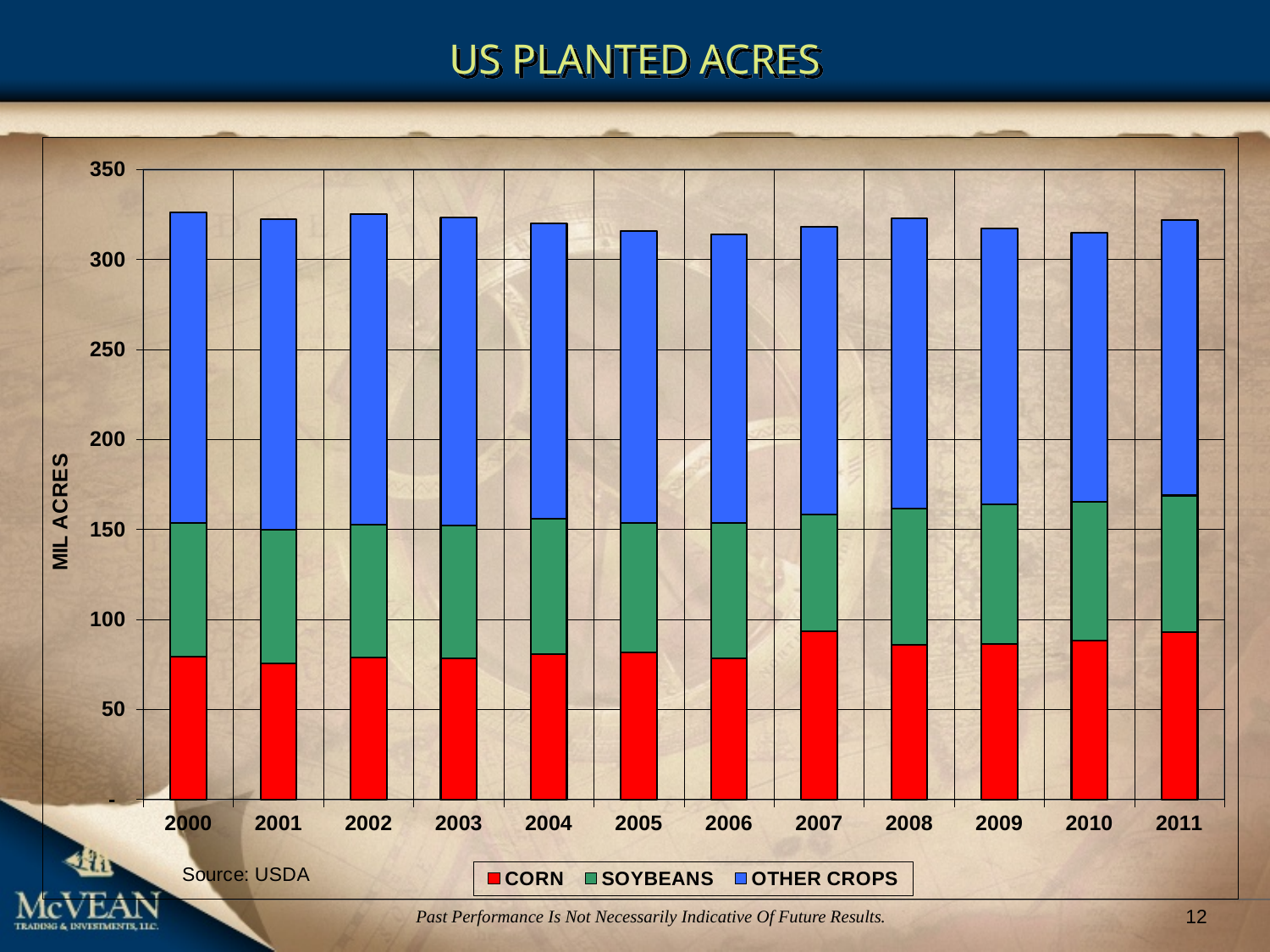
Is the total height of the stacked bar for 2000 greater or less than 300? greater Which is larger, the total stacked bar for 2000 or the total stacked bar for 2006? 2000 Is the total height of the stacked bar for 2006 greater or less than 350? less How many years are shown on the x axis? 12 Is the CORN value for 2000 greater or less than 100? less What is the label on the vertical axis? MIL ACRES What kind of chart is shown on the slide? Stacked bar chart Which series are listed in the legend? CORN, SOYBEANS, OTHER CROPS Which is larger, the CORN value for 2007 or the CORN value for 2001? 2007 What is the title of the chart? US PLANTED ACRES How many series does the legend list? 3